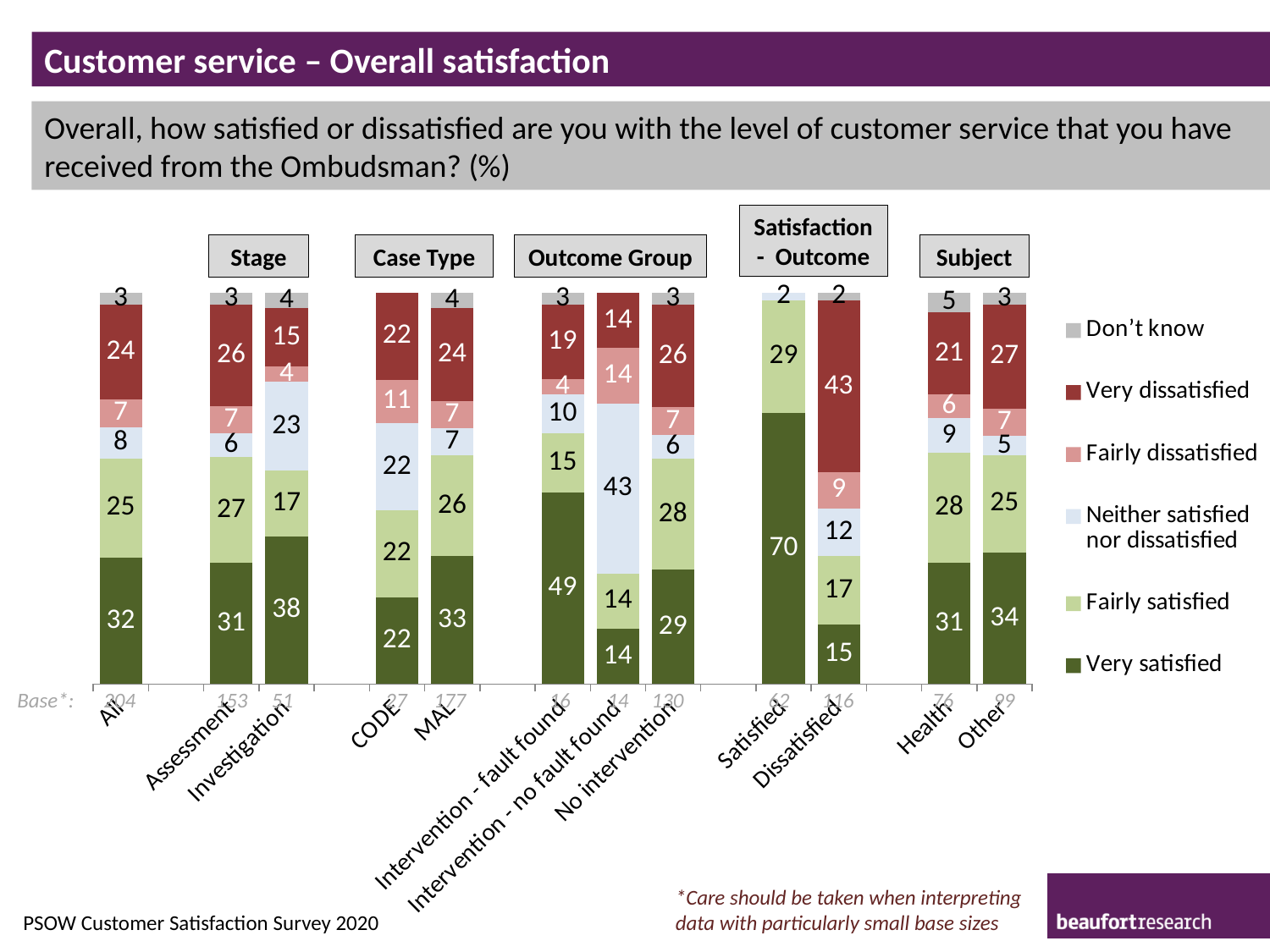
How many series does the legend list? 6 How many categories are shown along the x axis? 12 What is the 'Neither satisfied nor dissatisfied' value for Intervention - no fault found? 43 What is the base size shown for the 'All' category? 204 What is the 'Very dissatisfied' value for the Dissatisfied (Satisfaction - Outcome) category? 43 What percentage of the 'All' group are very satisfied? 32 What is the difference between the 'Very satisfied' values for Investigation and Assessment? 7 Which category has the highest 'Very satisfied' value? Satisfied What is the 'Fairly satisfied' value for Investigation? 17 Which category has the lowest 'Very satisfied' value? Intervention - no fault found What kind of chart is shown on the slide? Stacked bar chart Which has a larger 'Very dissatisfied' value, Health or Other? Other